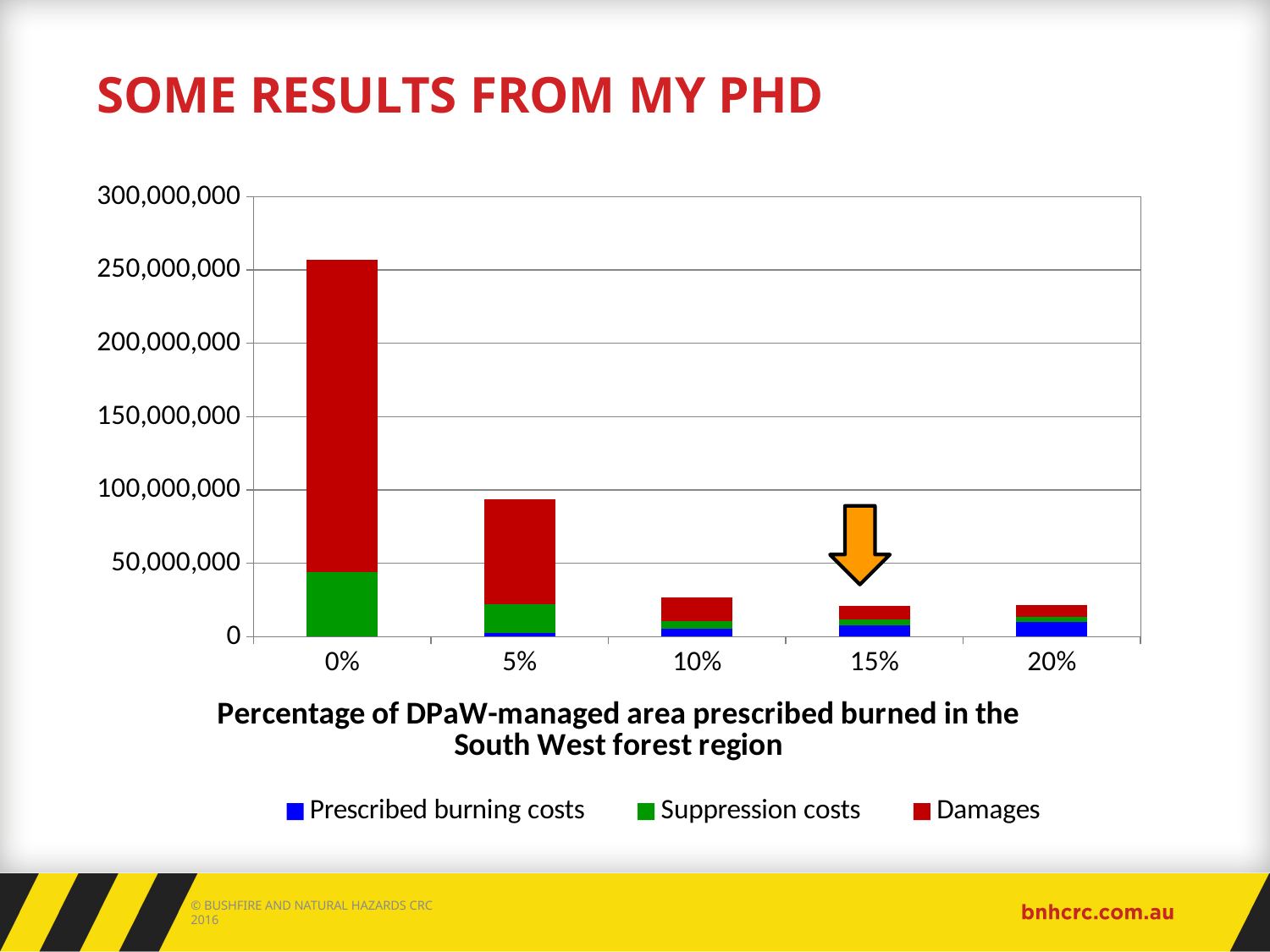
Do the total stacked bar values generally rise or fall as the percentage of area prescribed burned increases from 0% to 20%? fall Which has the larger total stacked bar, the 0% category or the 5% category? 0% Is the total value for the 0% category greater or less than 200,000,000? greater Is the total value for the 5% category greater or less than 100,000,000? less Which series is shown in red in the chart? Damages How many categories are shown along the x axis of the chart? 5 Is the total value for the 10% category greater or less than 50,000,000? less What is the title of the x axis of the chart? Percentage of DPaW-managed area prescribed burned in the South West forest region Which category has the highest total stacked bar? 0% How many series does the chart's legend list? 3 Which has the larger Damages segment, the 5% category or the 10% category? 5% What kind of chart is shown on the slide? Stacked bar chart